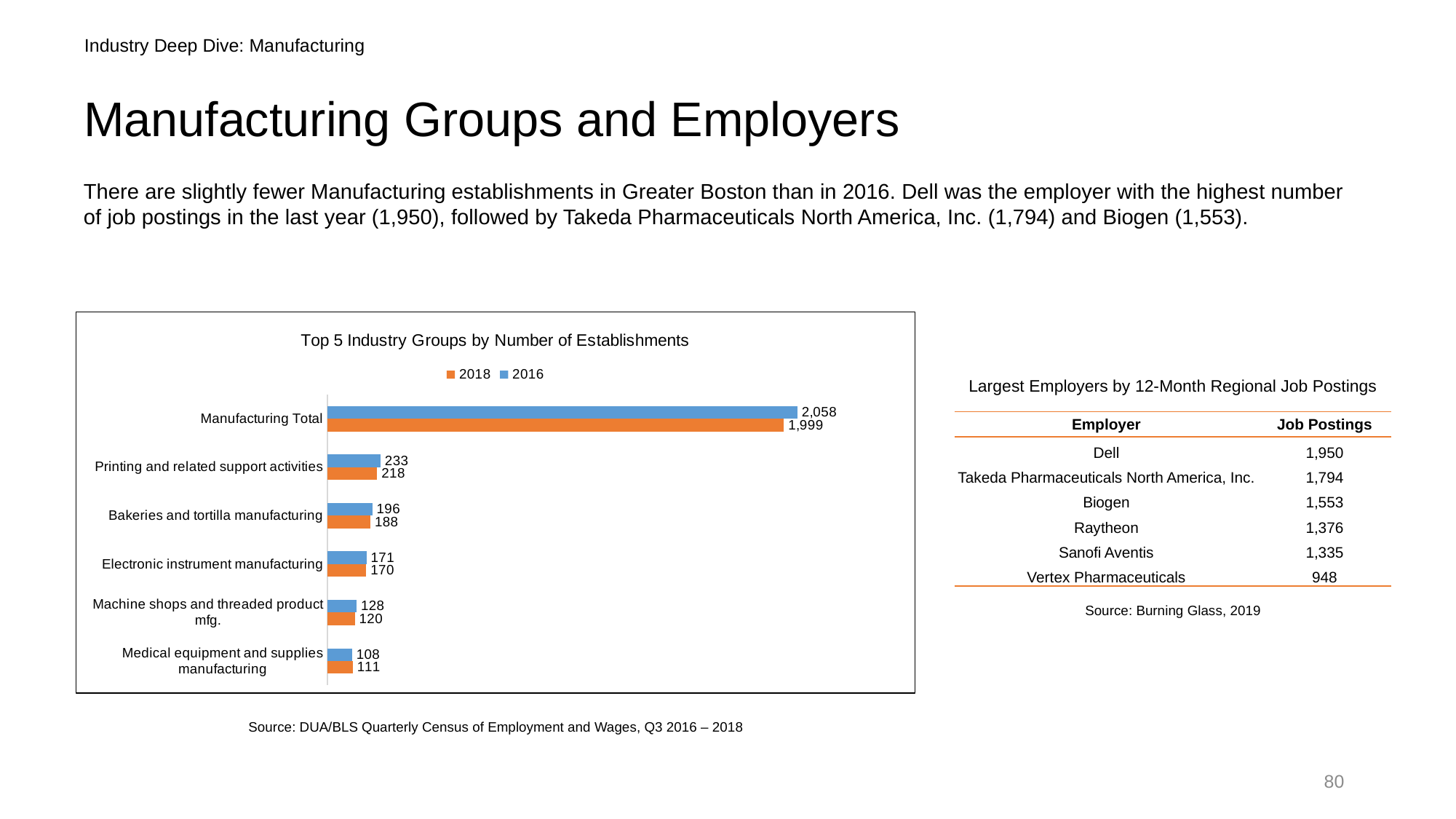
In the "Top 5 Industry Groups by Number of Establishments" chart, what is the 2018 value for Manufacturing Total? 1,999 In the "Top 5 Industry Groups by Number of Establishments" chart, what is the 2018 value for Medical equipment and supplies manufacturing? 111 In the "Top 5 Industry Groups by Number of Establishments" chart, what is the 2016 value for Manufacturing Total? 2,058 In the "Top 5 Industry Groups by Number of Establishments" chart, which industry group has the lowest 2018 value? Medical equipment and supplies manufacturing In the "Top 5 Industry Groups by Number of Establishments" chart, what is the 2016 value for Bakeries and tortilla manufacturing? 196 In the "Top 5 Industry Groups by Number of Establishments" chart, excluding Manufacturing Total, which industry group has the highest 2016 value? Printing and related support activities How many series does the legend of the "Top 5 Industry Groups by Number of Establishments" chart list? 2 In the "Top 5 Industry Groups by Number of Establishments" chart, what is the difference between the 2016 and 2018 values for Manufacturing Total? 59 How many categories are shown on the y axis of the "Top 5 Industry Groups by Number of Establishments" chart? 6 What type of chart is "Top 5 Industry Groups by Number of Establishments"? bar chart In the "Top 5 Industry Groups by Number of Establishments" chart, is the 2016 value for Machine shops and threaded product mfg. larger or smaller than its 2018 value? larger In the "Top 5 Industry Groups by Number of Establishments" chart, what is the 2018 value for Printing and related support activities? 218